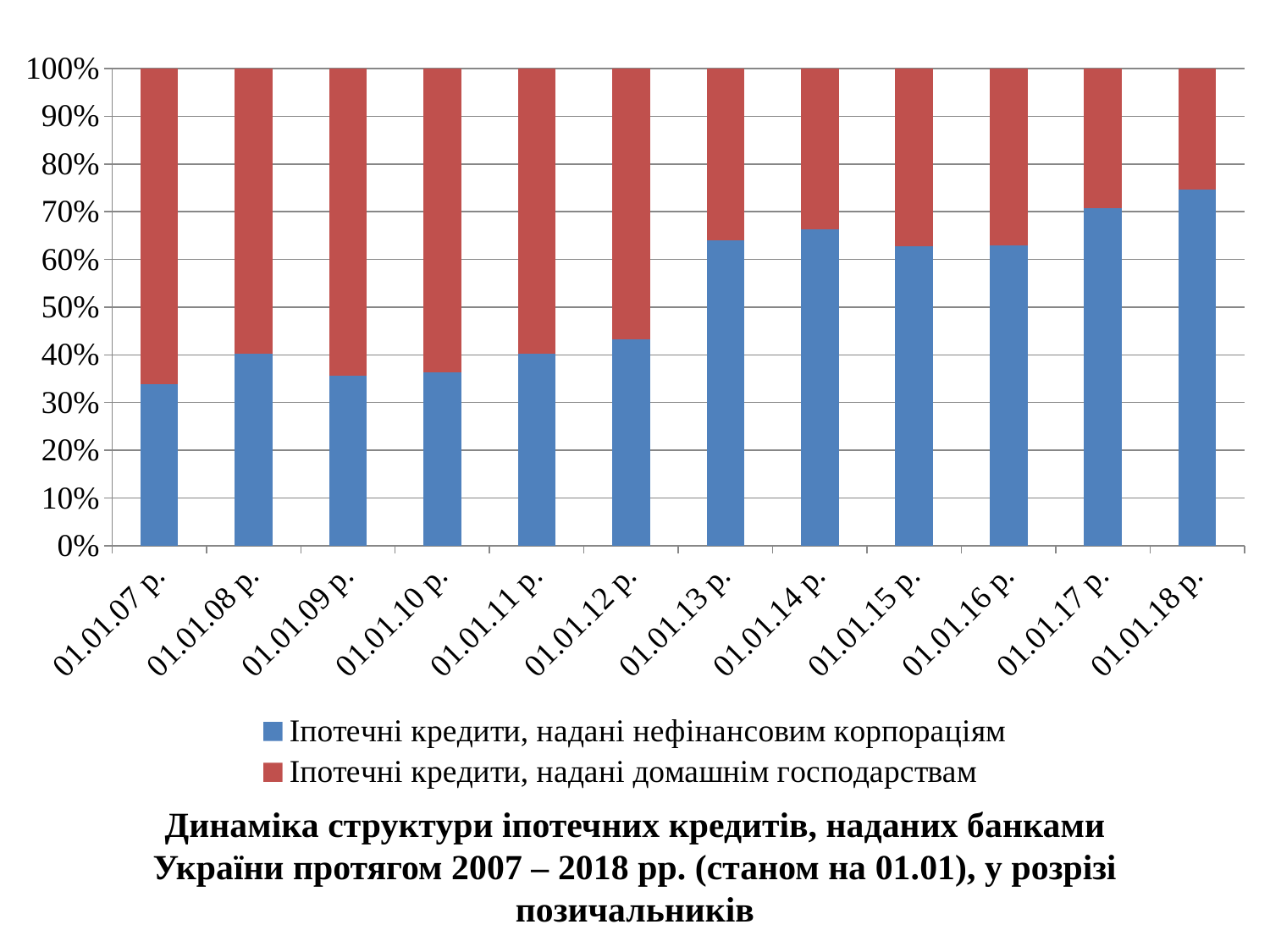
Which date has the highest share of mortgage loans granted to households (Іпотечні кредити, надані домашнім господарствам)? 01.01.07 р. Does the share of mortgage loans granted to non-financial corporations generally rise or fall from 01.01.07 р. to 01.01.18 р.? rise How many series does the legend list? 2 Which date has the highest share of mortgage loans granted to non-financial corporations (Іпотечні кредити, надані нефінансовим корпораціям)? 01.01.18 р. Which date has the lowest share of mortgage loans granted to non-financial corporations (Іпотечні кредити, надані нефінансовим корпораціям)? 01.01.07 р. Which date has a larger share of mortgage loans granted to non-financial corporations: 01.01.12 р. or 01.01.13 р.? 01.01.13 р. Is the share of mortgage loans granted to non-financial corporations on 01.01.18 р. greater or less than 70%? greater Is the share of mortgage loans granted to non-financial corporations on 01.01.07 р. greater or less than 40%? less What colour represents mortgage loans granted to households (Іпотечні кредити, надані домашнім господарствам) in the chart? Red What kind of chart is shown on the slide? Stacked bar chart How many dates (categories) are shown along the x axis? 12 Is the share of mortgage loans granted to households on 01.01.12 р. greater or less than 50%? greater